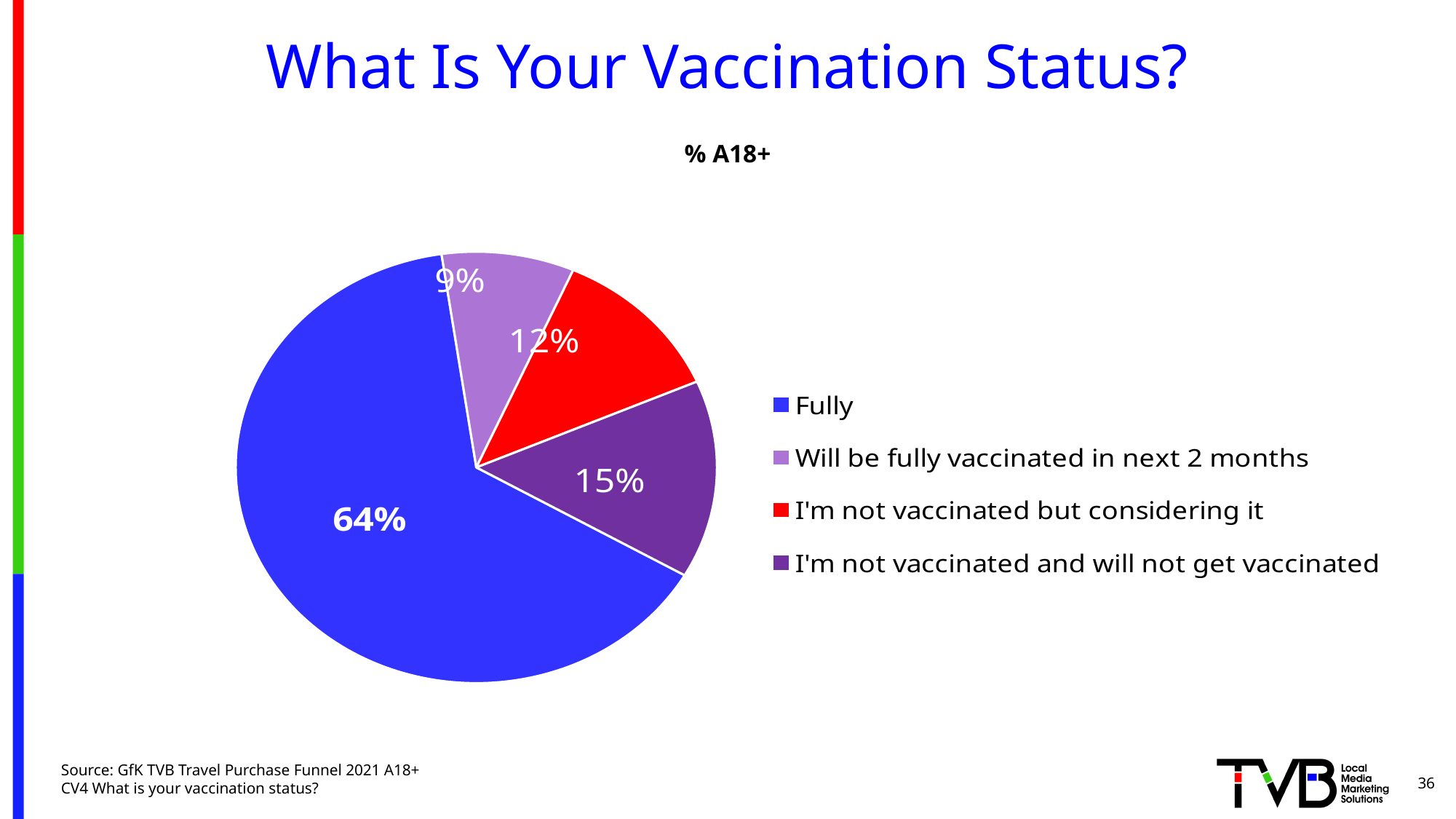
What percentage of respondents are not vaccinated but considering it? 12% Which vaccination status category has the smallest share of the pie? Will be fully vaccinated in next 2 months What percentage of respondents will be fully vaccinated in the next 2 months? 9% How many categories does the pie chart show? 4 What percentage of respondents are not vaccinated and will not get vaccinated? 15% What percentage of respondents are fully vaccinated? 64% Which is larger: the share for 'I'm not vaccinated but considering it' or 'I'm not vaccinated and will not get vaccinated'? I'm not vaccinated and will not get vaccinated What is the title of the chart? % A18+ Which vaccination status category has the largest share of the pie? Fully What type of chart is shown on the slide? Pie chart What is the difference in percentage points between 'Fully' and 'I'm not vaccinated and will not get vaccinated'? 49 What colour is the slice for 'I'm not vaccinated but considering it'? Red